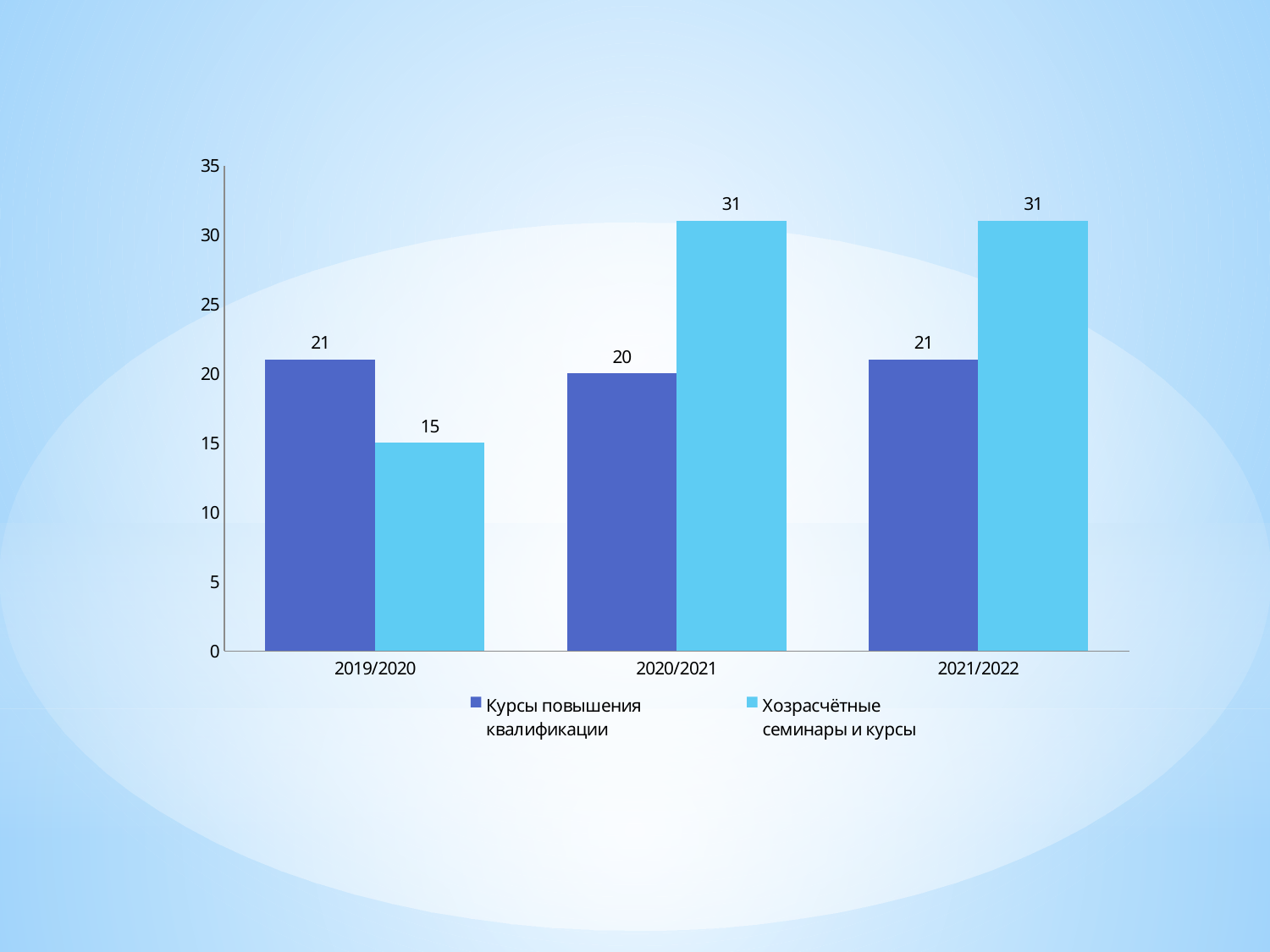
What is the value for Курсы повышения квалификации in 2020/2021? 20 Does the value for Хозрасчётные семинары и курсы rise or fall from 2019/2020 to 2020/2021? Rise In which year is the value for Курсы повышения квалификации lowest? 2020/2021 What is the difference between Хозрасчётные семинары и курсы and Курсы повышения квалификации in 2020/2021? 11 What is the value for Хозрасчётные семинары и курсы in 2021/2022? 31 How many series does the legend list? 2 What kind of chart is shown on the slide? Bar chart What is the value for Курсы повышения квалификации in 2019/2020? 21 In which year is the value for Хозрасчётные семинары и курсы lowest? 2019/2020 Which series has the larger value in 2019/2020, Курсы повышения квалификации or Хозрасчётные семинары и курсы? Курсы повышения квалификации What is the value for Хозрасчётные семинары и курсы in 2019/2020? 15 How many year categories are shown on the x axis? 3